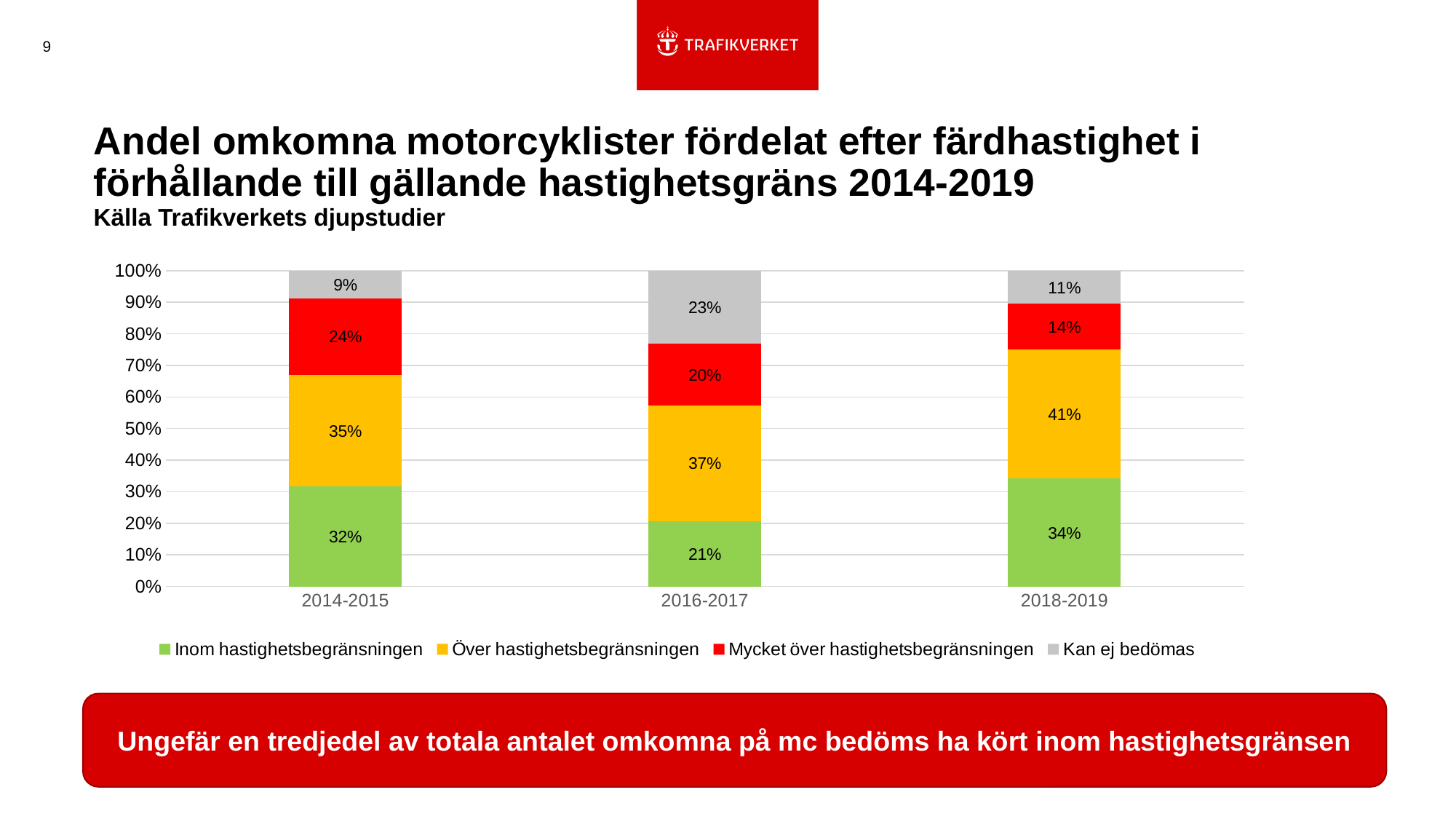
How many time periods are shown on the x axis? 3 What kind of chart is shown on the slide? Stacked bar chart What is the value for Kan ej bedömas in 2016-2017? 23% How much larger is the Inom hastighetsbegränsningen share in 2018-2019 than in 2016-2017? 13 percentage points Which period has the larger share for Kan ej bedömas, 2014-2015 or 2018-2019? 2018-2019 What is the value for Mycket över hastighetsbegränsningen in 2018-2019? 14% What share of killed motorcyclists in 2016-2017 were driving within the speed limit (Inom hastighetsbegränsningen)? 21% In which period is the share for Över hastighetsbegränsningen the highest? 2018-2019 What colour represents Kan ej bedömas in the chart? Grey Does the share for Mycket över hastighetsbegränsningen rise or fall from 2014-2015 to 2018-2019? Fall In which period is the share for Mycket över hastighetsbegränsningen the lowest? 2018-2019 How many series does the legend list? 4